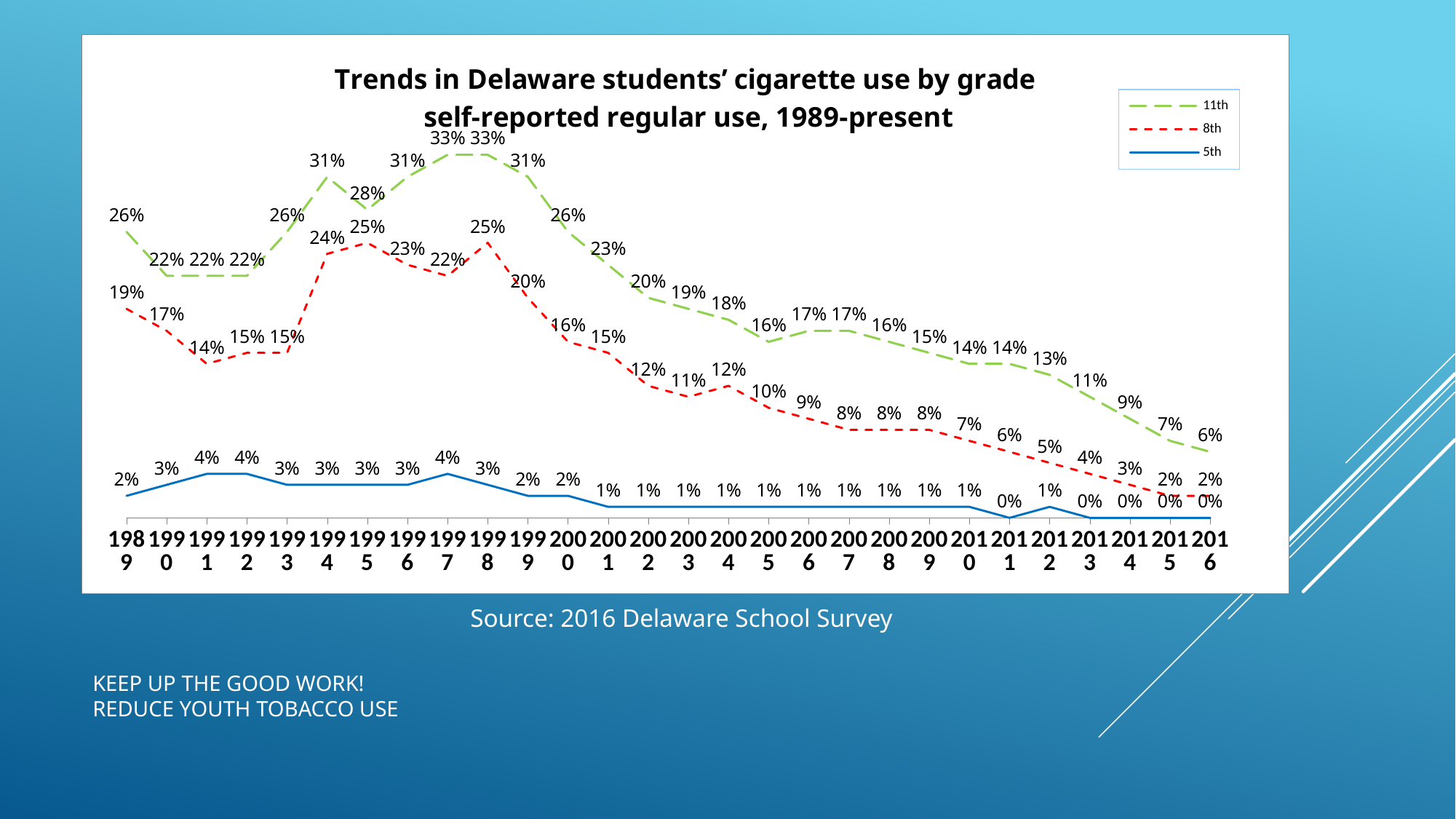
Which series had the higher value in 1994, 11th or 8th? 11th How many years are shown on the x axis? 28 What kind of chart is this? Line chart Does the 11th grade series rise or fall from 1998 to 2016? Fall What was the value for 11th graders in 2016? 6% What was the value for 8th graders in 1998? 25% How many series does the legend list? 3 What is the difference between the 11th grade and 8th grade values in 2000? 10% What is the highest value reached by the 11th grade series? 33% In which year did the 8th grade series reach its lowest value before 2015? 2014 What was the self-reported regular cigarette use for 11th graders in 1989? 26% What was the value for 5th graders in 2016? 0%